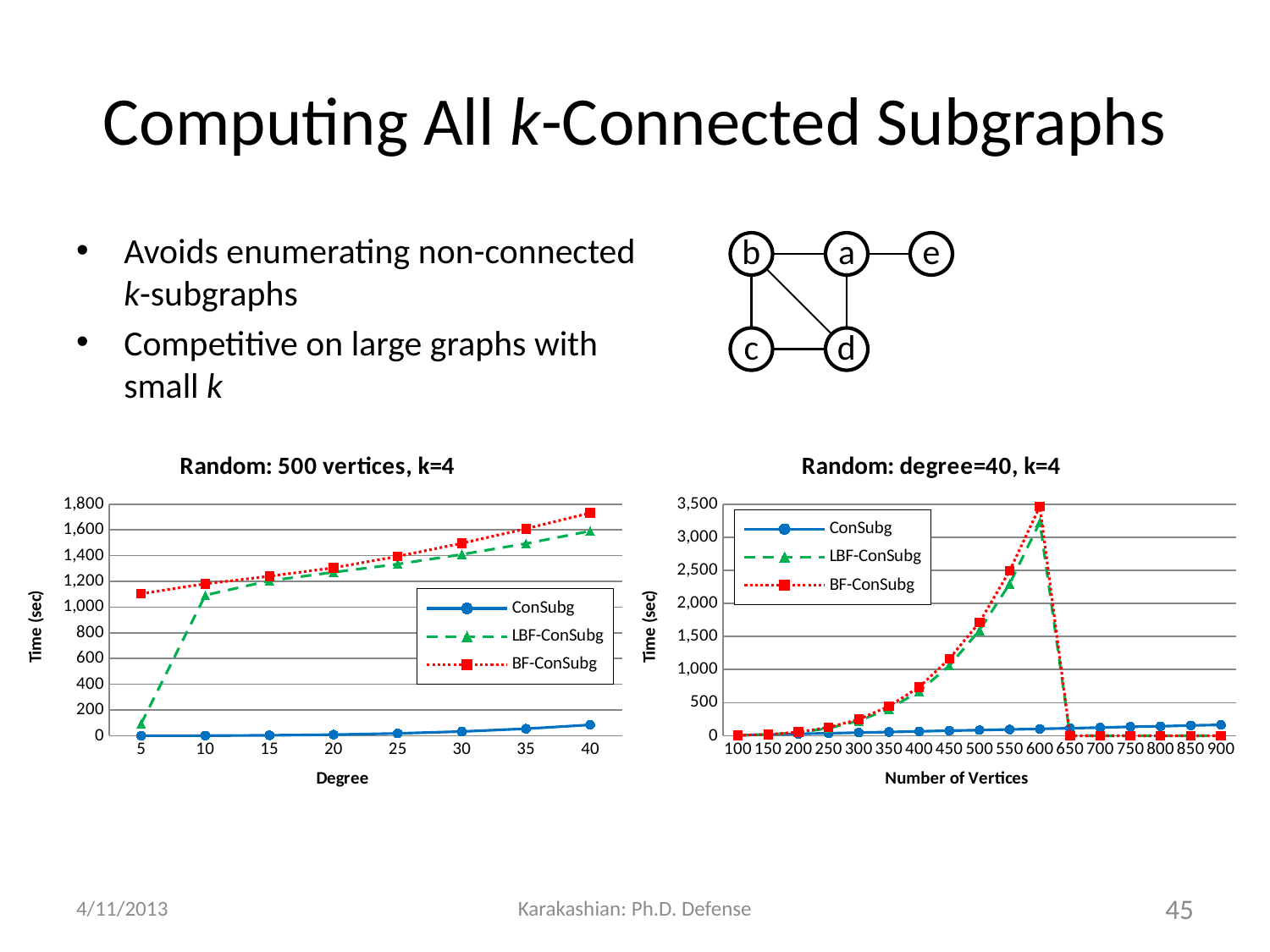
On the chart titled "Random: 500 vertices, k=4", is the value for LBF-ConSubg at degree 5 greater or less than 200? less On the chart titled "Random: degree=40, k=4", how many vertex counts are plotted along the x axis? 17 On the chart titled "Random: degree=40, k=4", is the value for BF-ConSubg at 600 vertices greater or less than 3,000? greater On the chart titled "Random: 500 vertices, k=4", how many series does the legend list? 3 On the chart titled "Random: 500 vertices, k=4", what kind of chart is shown? line chart On the chart titled "Random: 500 vertices, k=4", how many degree values are plotted along the x axis? 8 On the chart titled "Random: degree=40, k=4", at 500 vertices, which series has the larger value: BF-ConSubg or ConSubg? BF-ConSubg On the chart titled "Random: 500 vertices, k=4", does the BF-ConSubg series rise or fall as degree increases? rise On the chart titled "Random: degree=40, k=4", at which number of vertices does BF-ConSubg reach its highest value? 600 On the chart titled "Random: degree=40, k=4", what is the x-axis title? Number of Vertices On the chart titled "Random: 500 vertices, k=4", is the value for BF-ConSubg at degree 5 greater or less than 1,000? greater On the chart titled "Random: 500 vertices, k=4", at degree 40, which series has the larger value: BF-ConSubg or LBF-ConSubg? BF-ConSubg